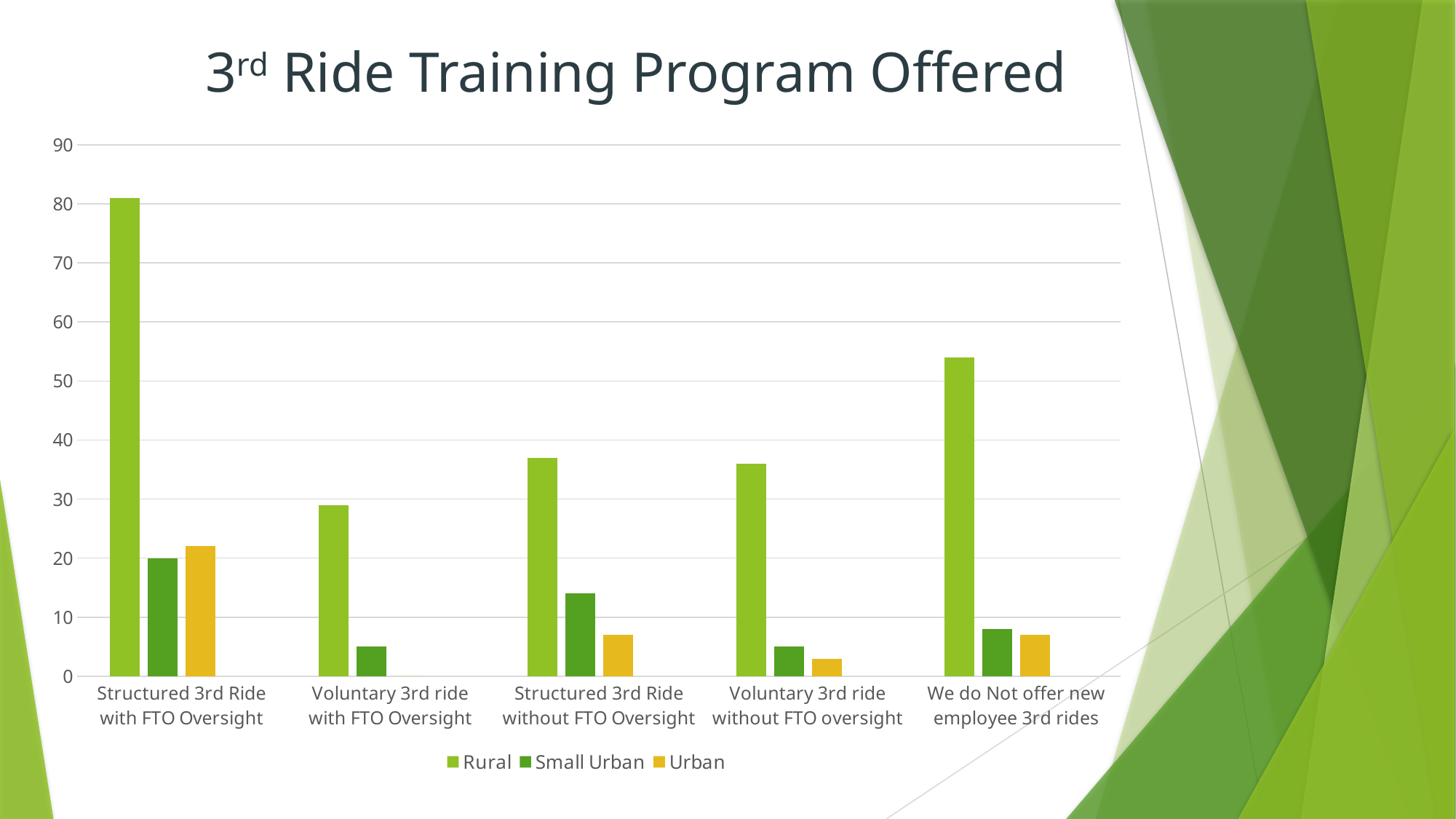
Is the Urban value for Voluntary 3rd ride without FTO oversight greater or less than 10? less How many categories are shown on the x axis? 5 For Structured 3rd Ride with FTO Oversight, which is larger: the Small Urban value or the Urban value? Urban Is the Small Urban value for Structured 3rd Ride without FTO Oversight greater or less than 10? greater What is the title of the chart? 3rd Ride Training Program Offered Which category has the lowest Rural value? Voluntary 3rd ride with FTO Oversight How many series does the legend list? 3 Which is larger: the Rural value for Voluntary 3rd ride with FTO Oversight or the Rural value for Structured 3rd Ride without FTO Oversight? Structured 3rd Ride without FTO Oversight Which category has the highest Rural value? Structured 3rd Ride with FTO Oversight Is the Rural value for We do Not offer new employee 3rd rides greater or less than 50? greater What kind of chart is shown on the slide? bar chart